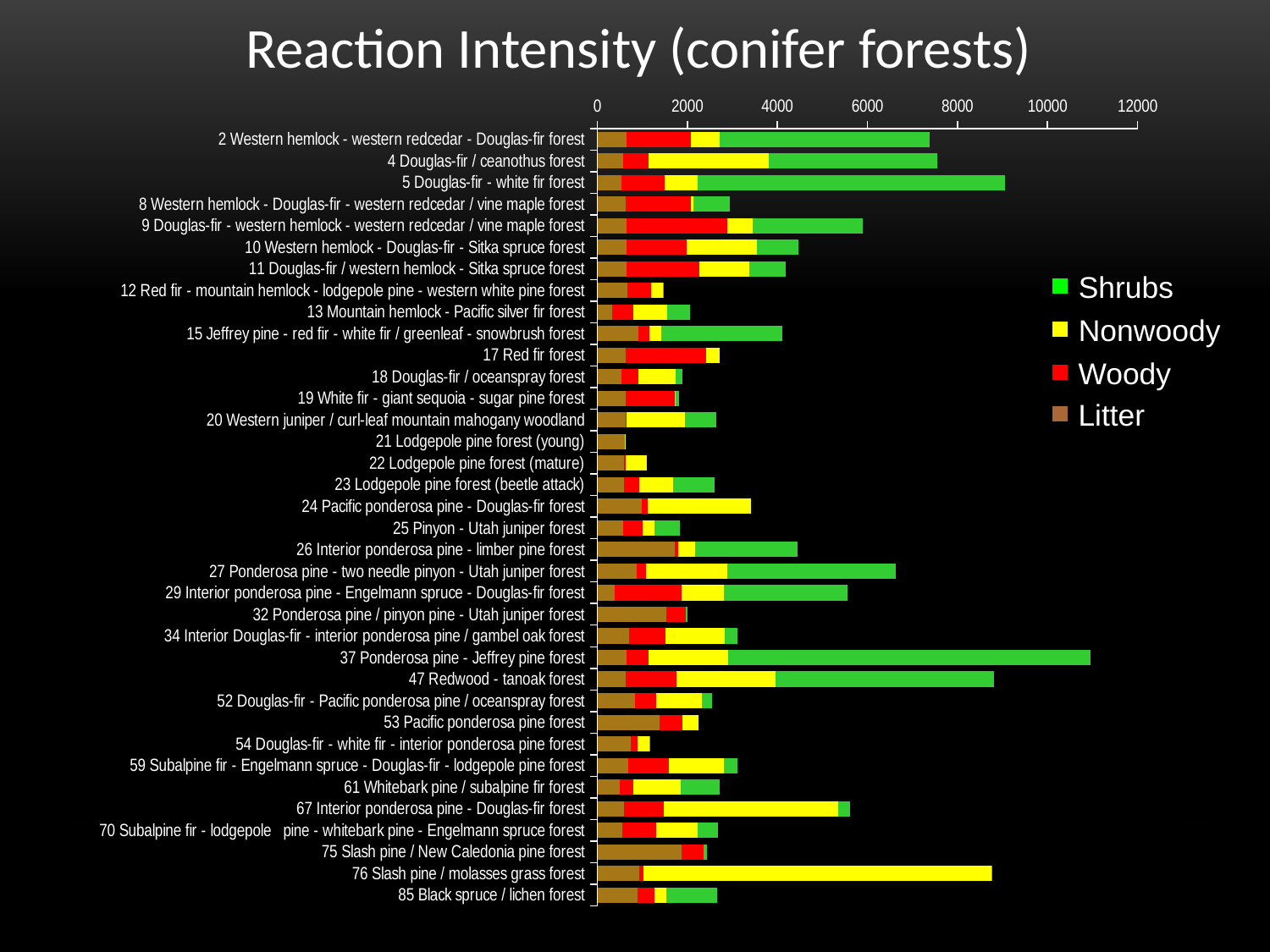
Which forest category has the lowest total reaction intensity? 21 Lodgepole pine forest (young) How many series does the legend list? 4 Which series is shown in green in the legend? Shrubs Is the total value for 21 Lodgepole pine forest (young) greater or less than 2000? less Which has the larger total value: 4 Douglas-fir / ceanothus forest or 8 Western hemlock - Douglas-fir - western redcedar / vine maple forest? 4 Douglas-fir / ceanothus forest How many forest categories are plotted on the chart? 36 Which forest category has the highest total reaction intensity? 37 Ponderosa pine - Jeffrey pine forest What is the title of the chart? Reaction Intensity (conifer forests) What kind of chart is shown on the slide? Stacked bar chart Which has the larger total value: 37 Ponderosa pine - Jeffrey pine forest or 47 Redwood - tanoak forest? 37 Ponderosa pine - Jeffrey pine forest Is the total value for 5 Douglas-fir - white fir forest greater or less than 8000? greater Is the total value for 27 Ponderosa pine - two needle pinyon - Utah juniper forest greater or less than 6000? greater